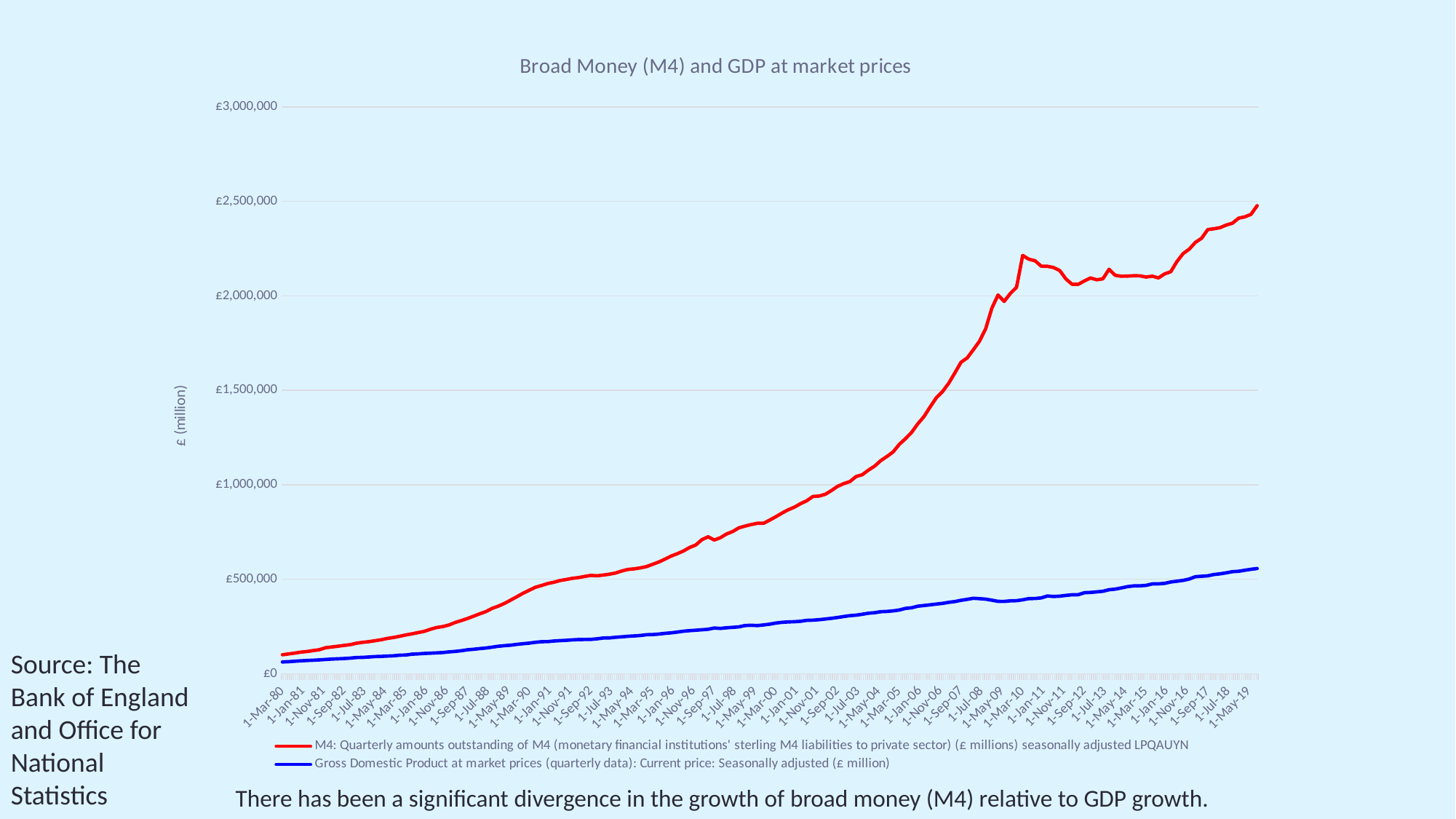
Does the Gross Domestic Product series generally rise or fall across the x axis? rise Does the M4 series generally rise or fall from 1-Mar-80 to 1-May-19? rise What colour is the line for Gross Domestic Product at market prices? blue What is the title of the chart? Broad Money (M4) and GDP at market prices Is the value of the M4 series at 1-May-19 greater or less than £2,000,000? greater What kind of chart is shown on the slide? line chart At 1-May-19, which series has the larger value, M4 or Gross Domestic Product? M4 Is the value of the M4 series at 1-Jan-06 greater or less than £1,000,000? greater Is the value of the Gross Domestic Product series at 1-Jul-08 greater or less than £500,000? less How many series does the legend list? 2